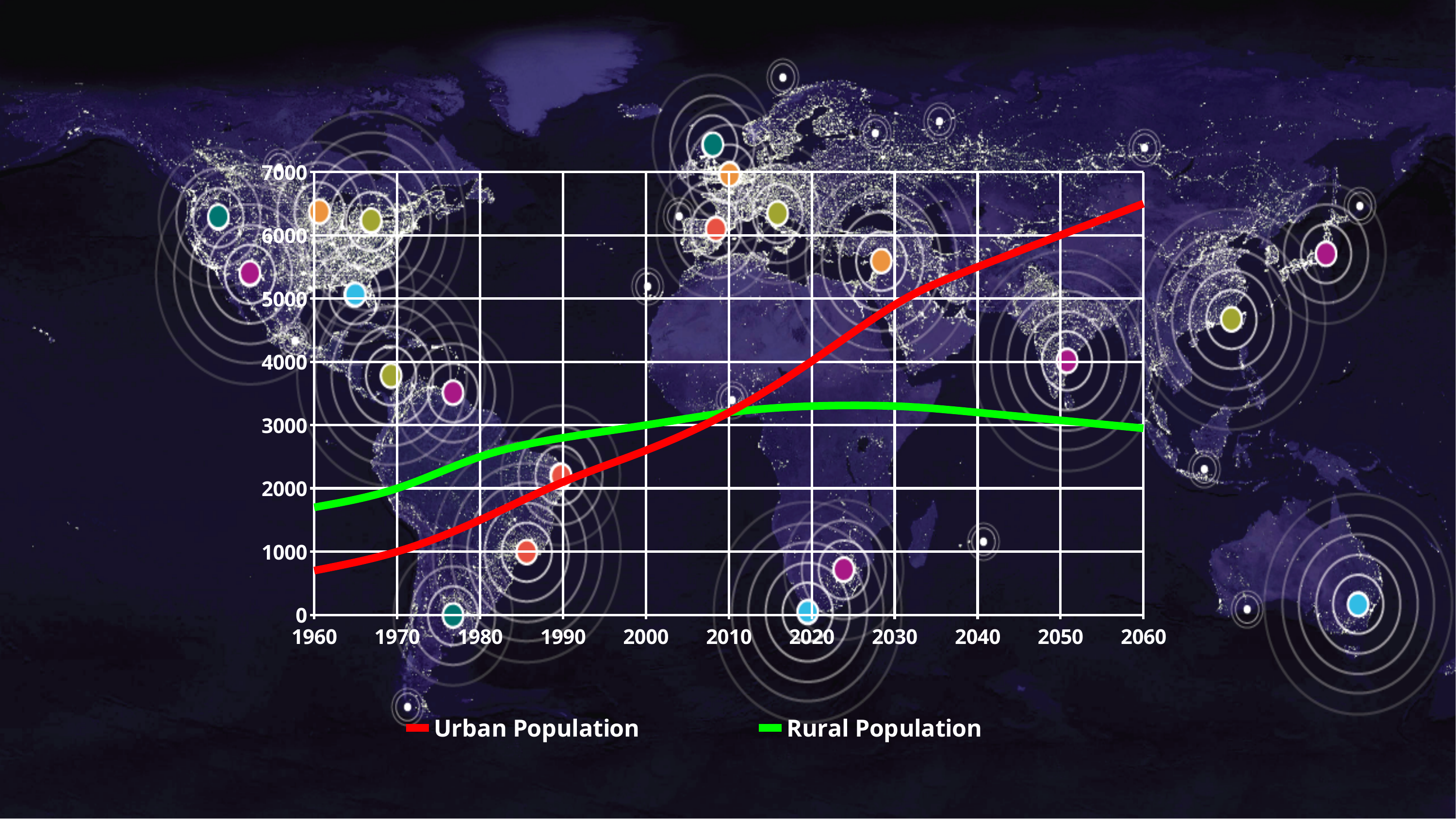
Is the Urban Population value in 2060 greater or less than 6000? greater What kind of chart is shown on the slide? line chart In 1980, which series has the larger value, Urban Population or Rural Population? Rural Population How many series does the legend list? 2 Is the Rural Population value in 1960 greater or less than 1000? greater Which series is drawn in green? Rural Population In 2040, which series has the larger value, Urban Population or Rural Population? Urban Population Does the Urban Population line rise or fall from 1960 to 2060? rise Is the Urban Population value in 1960 greater or less than 1000? less How many year labels are shown on the x axis? 11 Which series is drawn in red? Urban Population